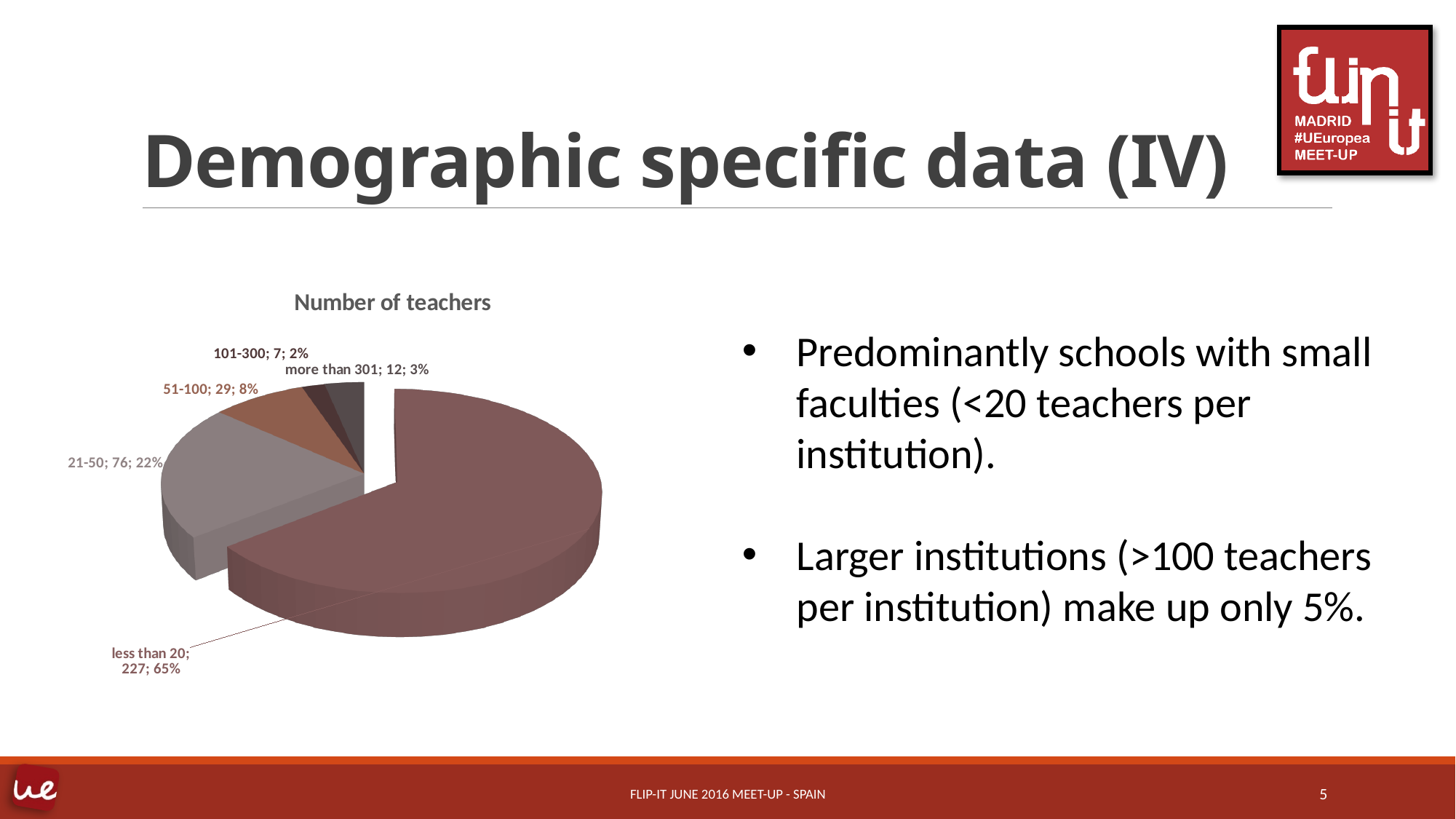
Which category has the smallest slice of the pie? 101-300 What is the title of the chart? Number of teachers How many institutions are in the '51-100' category? 29 How many institutions are in the 'less than 20' category? 227 What share of the pie does the 'more than 301' category represent? 3% Which category has the largest slice of the pie? less than 20 How many categories does the pie chart have? 5 Which category has more institutions, '51-100' or 'more than 301'? 51-100 What is the difference between the number of institutions in the 'less than 20' category and the '21-50' category? 151 What is the total number of institutions across all categories in the pie chart? 351 What share of the pie does the '21-50' category represent? 22% What kind of chart is shown on the slide? pie chart